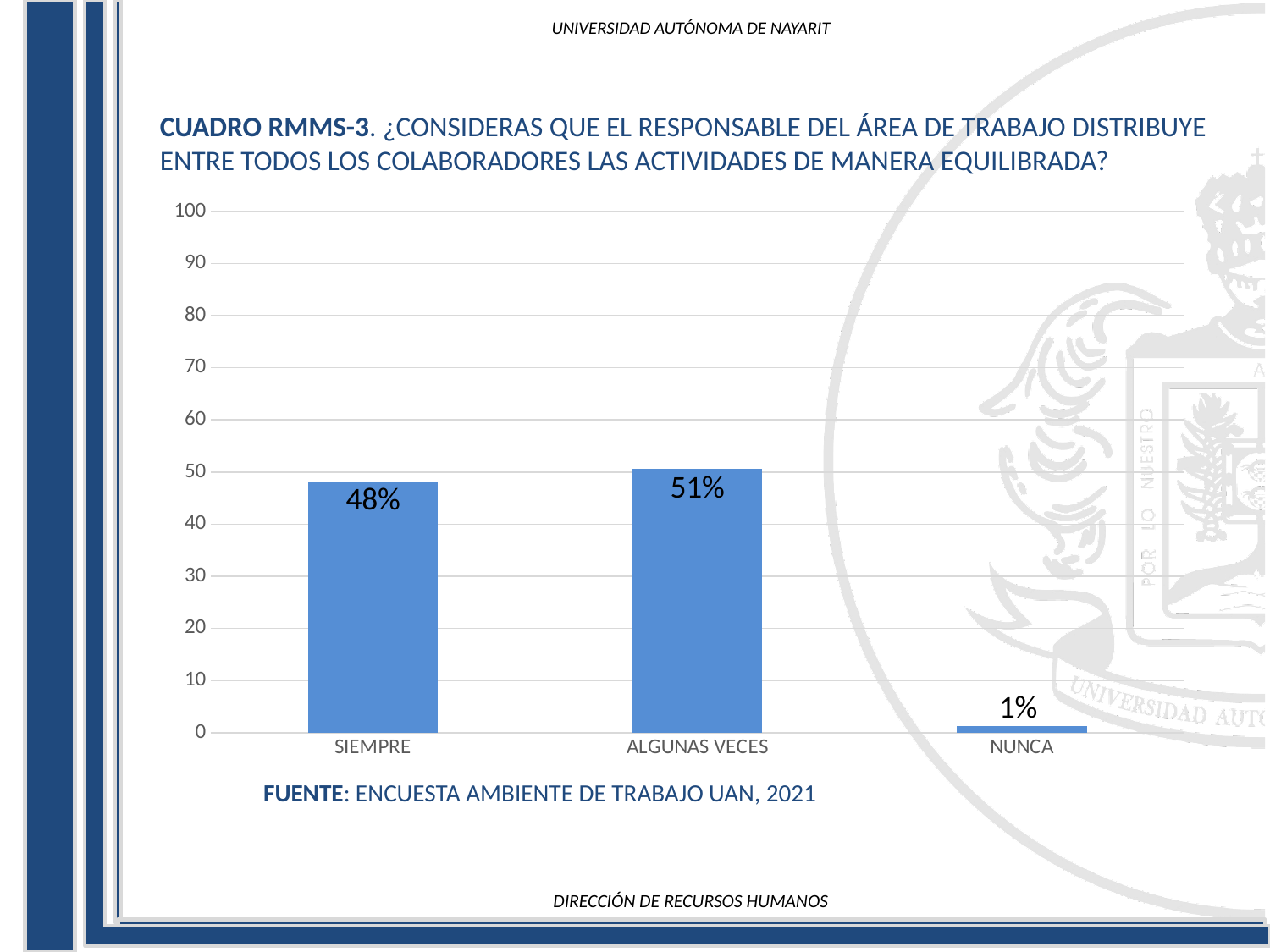
What is the value for SIEMPRE? 48% Which category has the lowest value? NUNCA What is the value for ALGUNAS VECES? 51% Which category has the highest value? ALGUNAS VECES What is the difference between the values for SIEMPRE and NUNCA? 47% Which is larger, the value for SIEMPRE or the value for NUNCA? SIEMPRE Is the value for SIEMPRE greater or less than 50? less What source is cited below the chart? ENCUESTA AMBIENTE DE TRABAJO UAN, 2021 How many categories are shown on the chart? 3 What kind of chart is shown on the slide? bar chart What is the difference between the values for ALGUNAS VECES and SIEMPRE? 3% What is the value for NUNCA? 1%